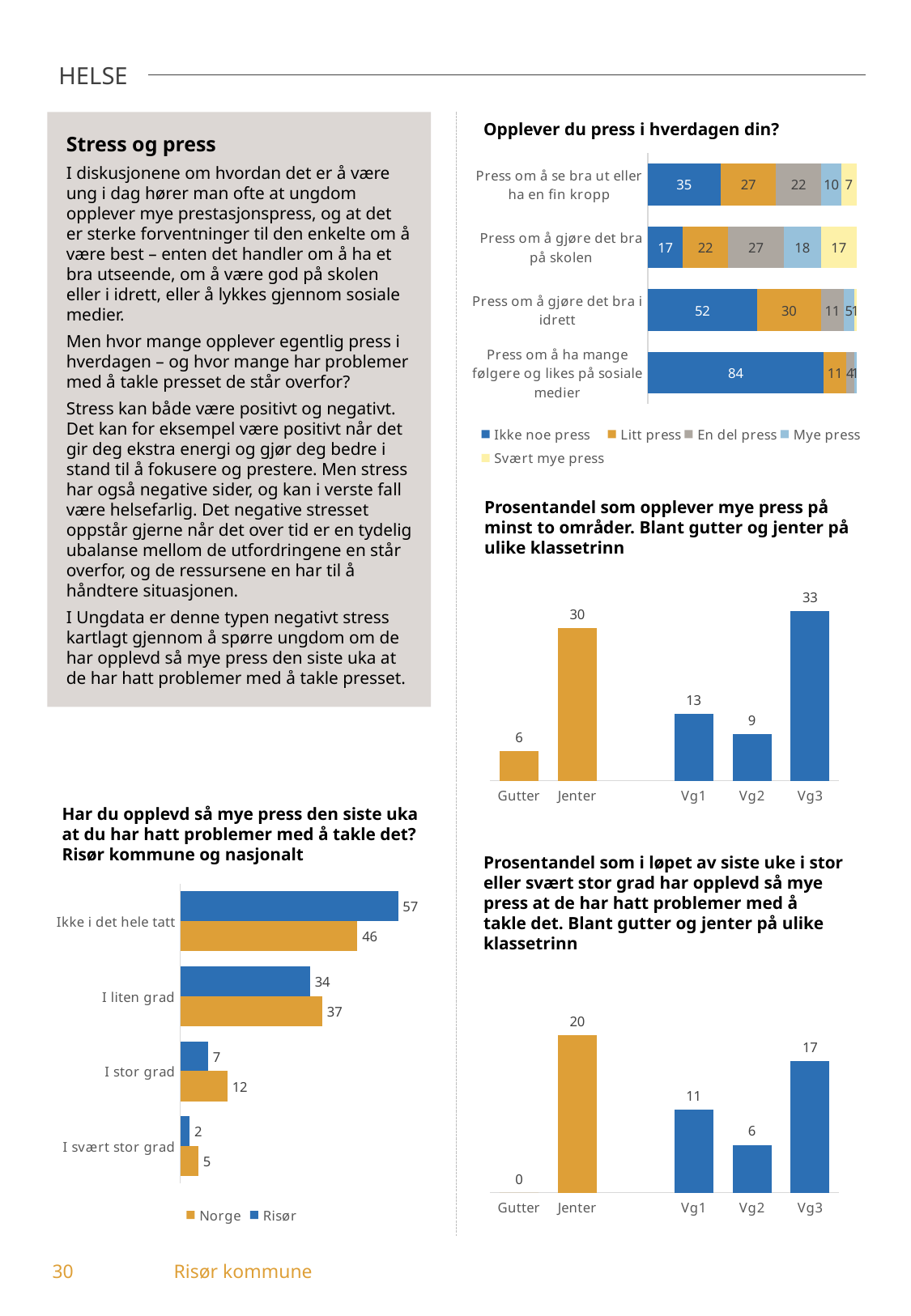
In the chart 'Har du opplevd så mye press den siste uka at du har hatt problemer med å takle det?', what is the difference between the Norge and Risør values for 'I liten grad'? 3 How many series does the legend of the chart 'Opplever du press i hverdagen din?' list? 5 In the chart 'Opplever du press i hverdagen din?', what is the difference between the 'Ikke noe press' values for 'Press om å gjøre det bra i idrett' and 'Press om å se bra ut eller ha en fin kropp'? 17 In the chart 'Prosentandel som i løpet av siste uke i stor eller svært stor grad har opplevd så mye press', which category has the lowest value? Gutter What kind of chart is 'Prosentandel som i løpet av siste uke i stor eller svært stor grad har opplevd så mye press'? Bar chart In the chart 'Opplever du press i hverdagen din?', what is the 'En del press' value for 'Press om å gjøre det bra på skolen'? 27 In the chart 'Prosentandel som opplever mye press på minst to områder', how many categories are shown? 5 In the chart 'Prosentandel som opplever mye press på minst to områder', what is the value for Jenter? 30 In the chart 'Har du opplevd så mye press den siste uka at du har hatt problemer med å takle det?', which is larger for 'I stor grad': Norge or Risør? Norge In the chart 'Opplever du press i hverdagen din?', what is the 'Ikke noe press' value for 'Press om å ha mange følgere og likes på sosiale medier'? 84 In the chart 'Prosentandel som opplever mye press på minst to områder', which category has the highest value? Vg3 In the chart 'Har du opplevd så mye press den siste uka at du har hatt problemer med å takle det?', what is the Risør value for 'Ikke i det hele tatt'? 57